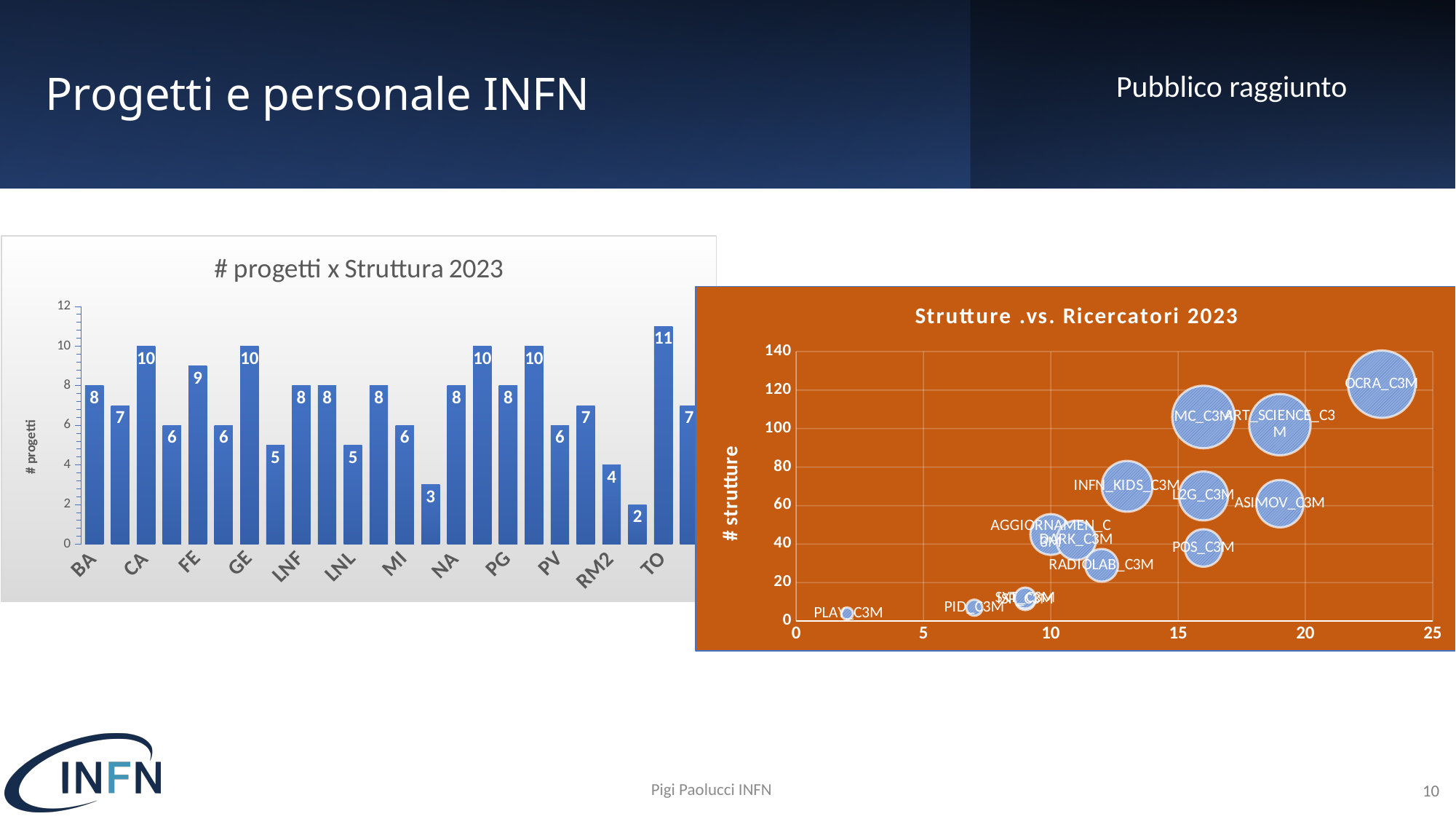
In the chart titled 'Strutture .vs. Ricercatori 2023', is the '# strutture' value for PLAY_C3M greater or less than 20? less In the chart titled '# progetti x Struttura 2023', what is the value for TO? 11 In the chart titled '# progetti x Struttura 2023', what is the value for BA? 8 In the chart titled '# progetti x Struttura 2023', what is the highest value shown on any bar? 11 In the chart titled '# progetti x Struttura 2023', what is the value for RM2? 4 In the chart titled '# progetti x Struttura 2023', what is the difference between the values for TO and BA? 3 In the chart titled '# progetti x Struttura 2023', what is the lowest value shown on any bar? 2 In the chart titled '# progetti x Struttura 2023', which labelled structure has the highest number of projects? TO In the chart titled 'Strutture .vs. Ricercatori 2023', is the '# strutture' value for MC_C3M greater or less than 80? greater What kind of chart is '# progetti x Struttura 2023'? bar chart In the chart titled 'Strutture .vs. Ricercatori 2023', which bubble has the highest value on the '# strutture' axis? OCRA_C3M What is the label of the vertical axis in the chart titled 'Strutture .vs. Ricercatori 2023'? # strutture